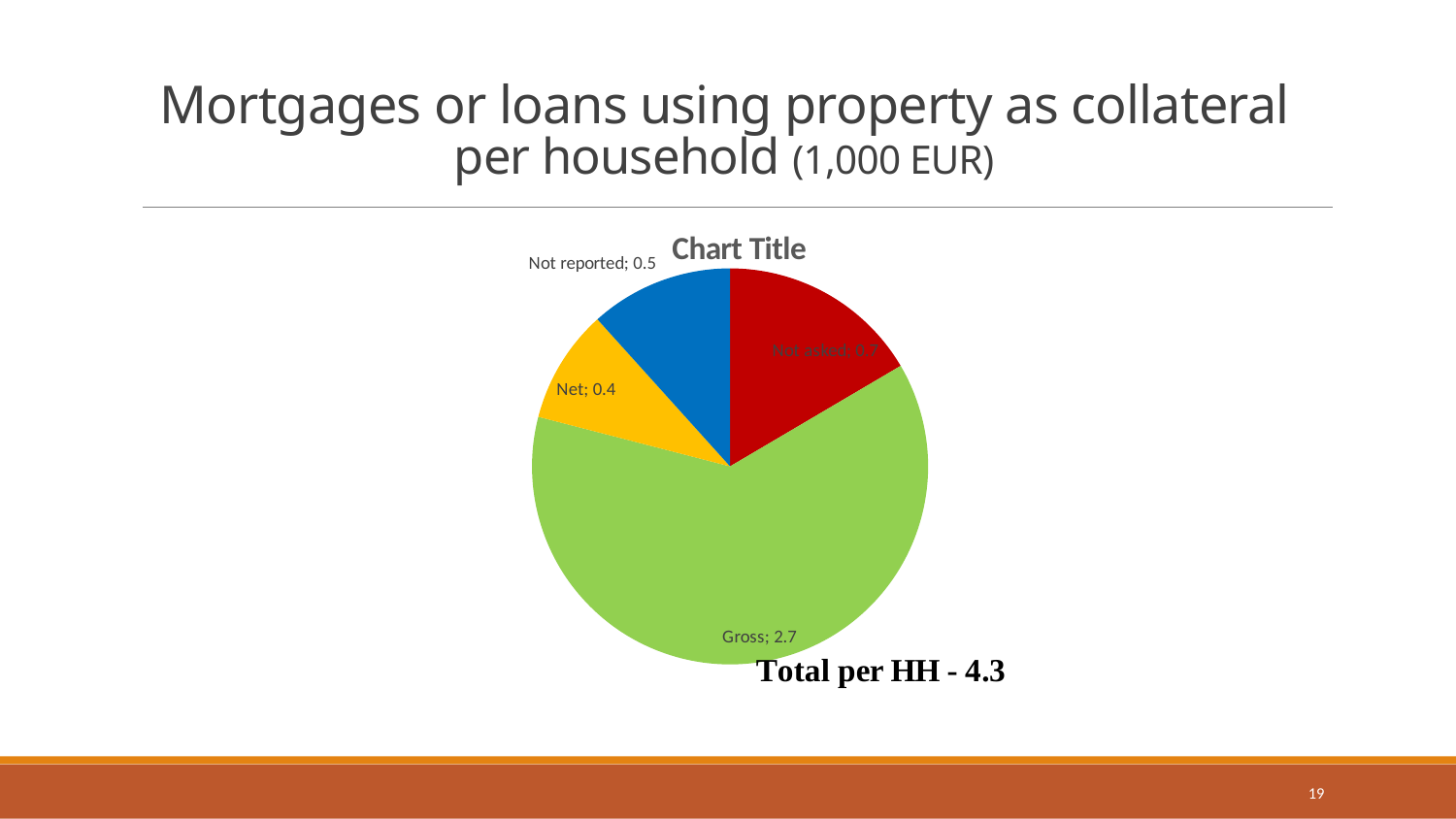
What kind of chart is shown on the slide? pie chart What is the difference between the Gross value and the Net value? 2.3 How many slices does the pie chart have? 4 What is the value for Gross in the pie chart? 2.7 Which is larger, the value for Not reported or the value for Net? Not reported Which slice of the pie chart has the largest value? Gross What is the value for Not reported in the pie chart? 0.5 What is the total per household shown below the pie chart? 4.3 Which slice of the pie chart has the smallest value? Net What title is printed above the pie chart? Chart Title What is the difference between the Not reported value and the Net value? 0.1 What is the value for Net in the pie chart? 0.4